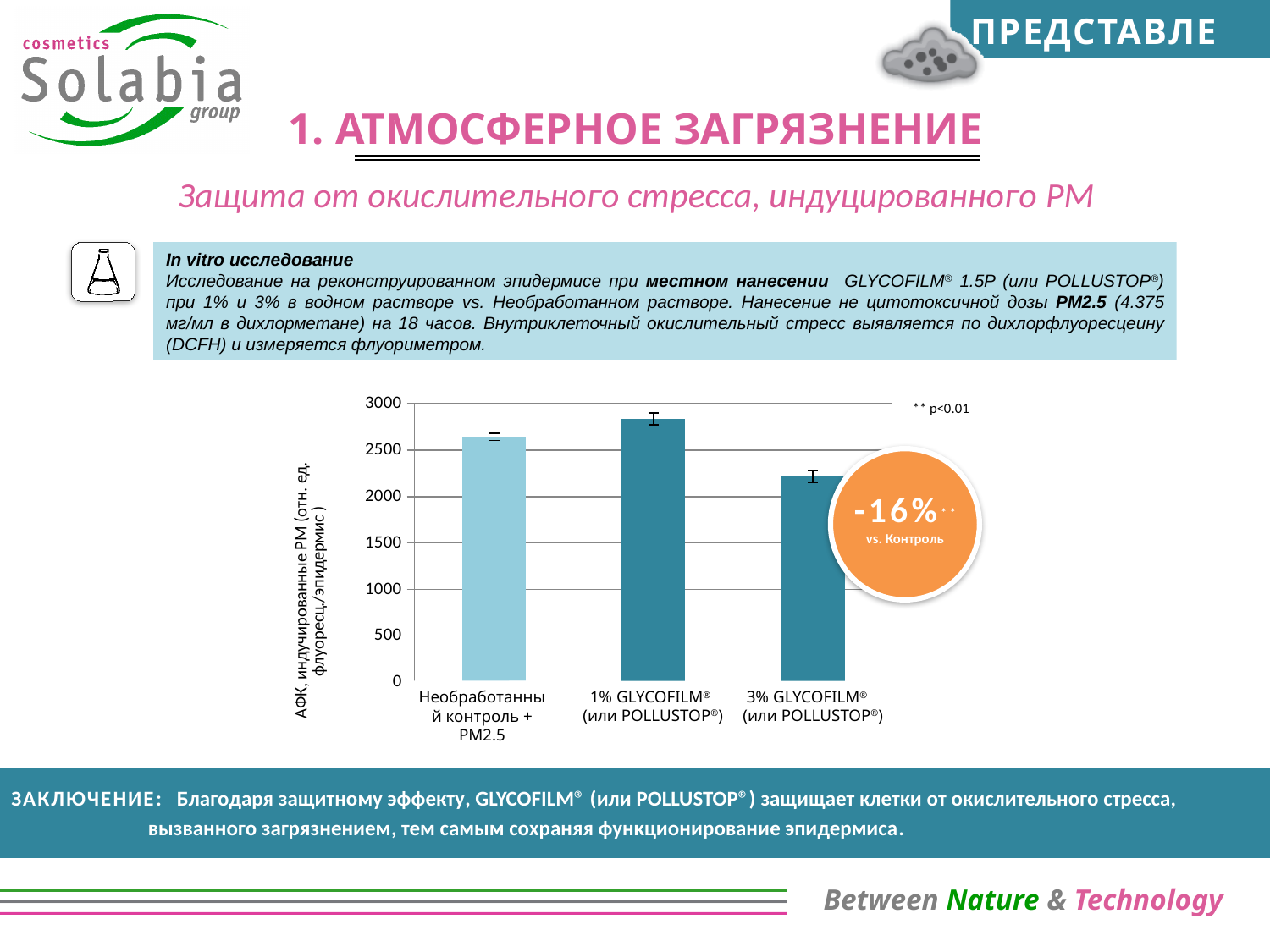
Which category has the highest bar in the chart? 1% GLYCOFILM® (или POLLUSTOP®) Is the value for 3% GLYCOFILM® (или POLLUSTOP®) greater or less than 2000? greater What is the maximum value shown on the y axis of the chart? 3000 Which is larger: the value for 1% GLYCOFILM® (или POLLUSTOP®) or the value for Необработанный контроль + PM2.5? 1% GLYCOFILM® (или POLLUSTOP®) Is the value for 1% GLYCOFILM® (или POLLUSTOP®) greater or less than 3000? less How many bars (categories) are plotted in the chart? 3 Is the value for 3% GLYCOFILM® (или POLLUSTOP®) greater or less than 2500? less What kind of chart is shown on the slide? bar chart Which category has the lowest bar in the chart? 3% GLYCOFILM® (или POLLUSTOP®) What percentage change vs. control is shown in the orange circle on the chart? -16% Which is larger: the value for 3% GLYCOFILM® (или POLLUSTOP®) or the value for Необработанный контроль + PM2.5? Необработанный контроль + PM2.5